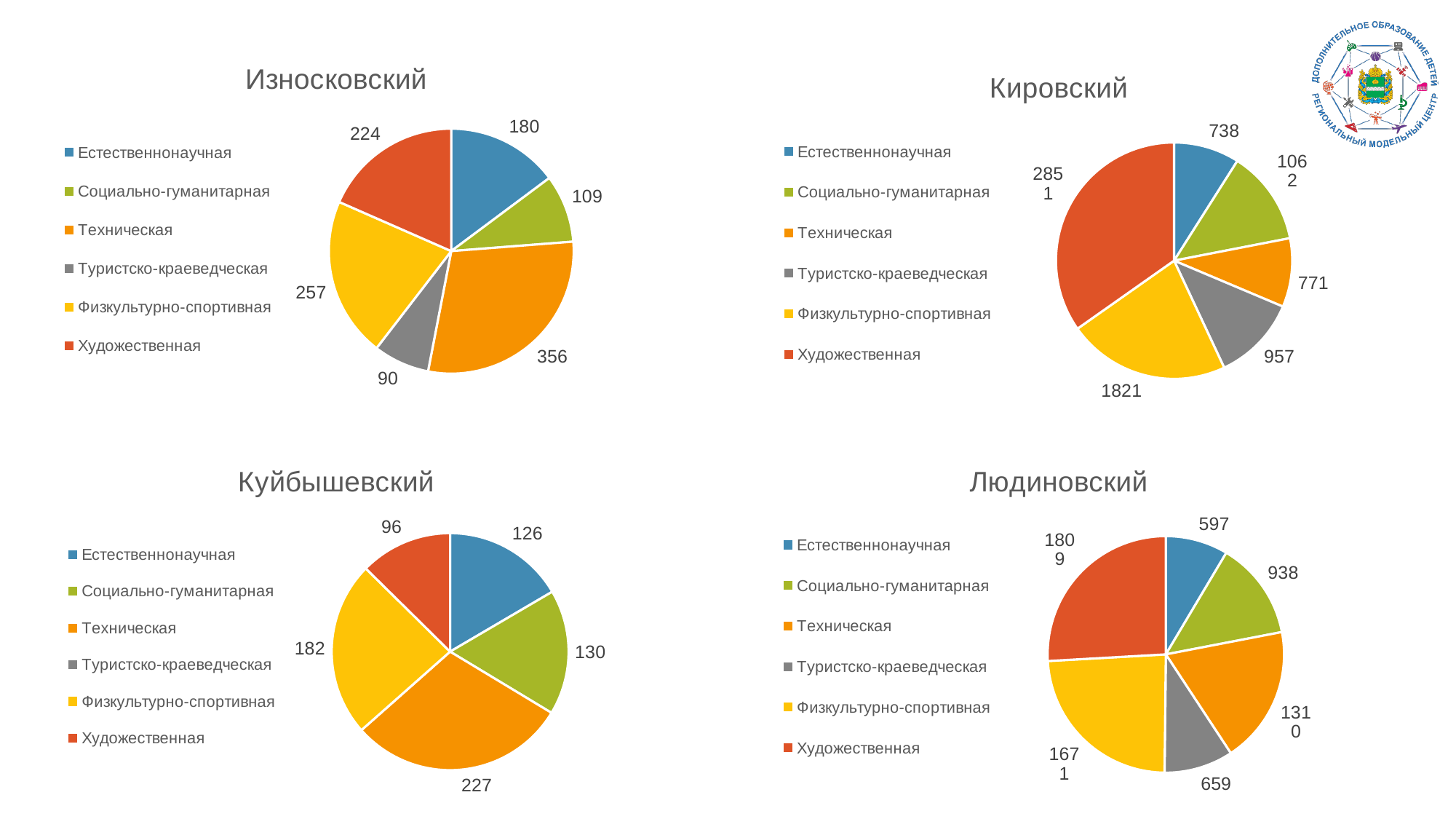
In the Износковский chart, which category has the smallest value? Туристско-краеведческая In the Износковский chart, what is the value for Техническая? 356 In the Кировский chart, what is the value for Физкультурно-спортивная? 1821 In the Людиновский chart, what is the value for Туристско-краеведческая? 659 In the Кировский chart, which category has the largest value? Художественная In the Куйбышевский chart, what is the value for Физкультурно-спортивная? 182 In the Куйбышевский chart, which category has the largest value? Техническая In the Кировский chart, which is larger, Естественнонаучная or Туристско-краеведческая? Туристско-краеведческая In the Куйбышевский chart, how many slices does the pie have? 5 What type of chart is the Людиновский chart? Pie chart In the Людиновский chart, what is the difference between Художественная and Физкультурно-спортивная? 138 In the Износковский chart, what is the difference between Физкультурно-спортивная and Художественная? 33